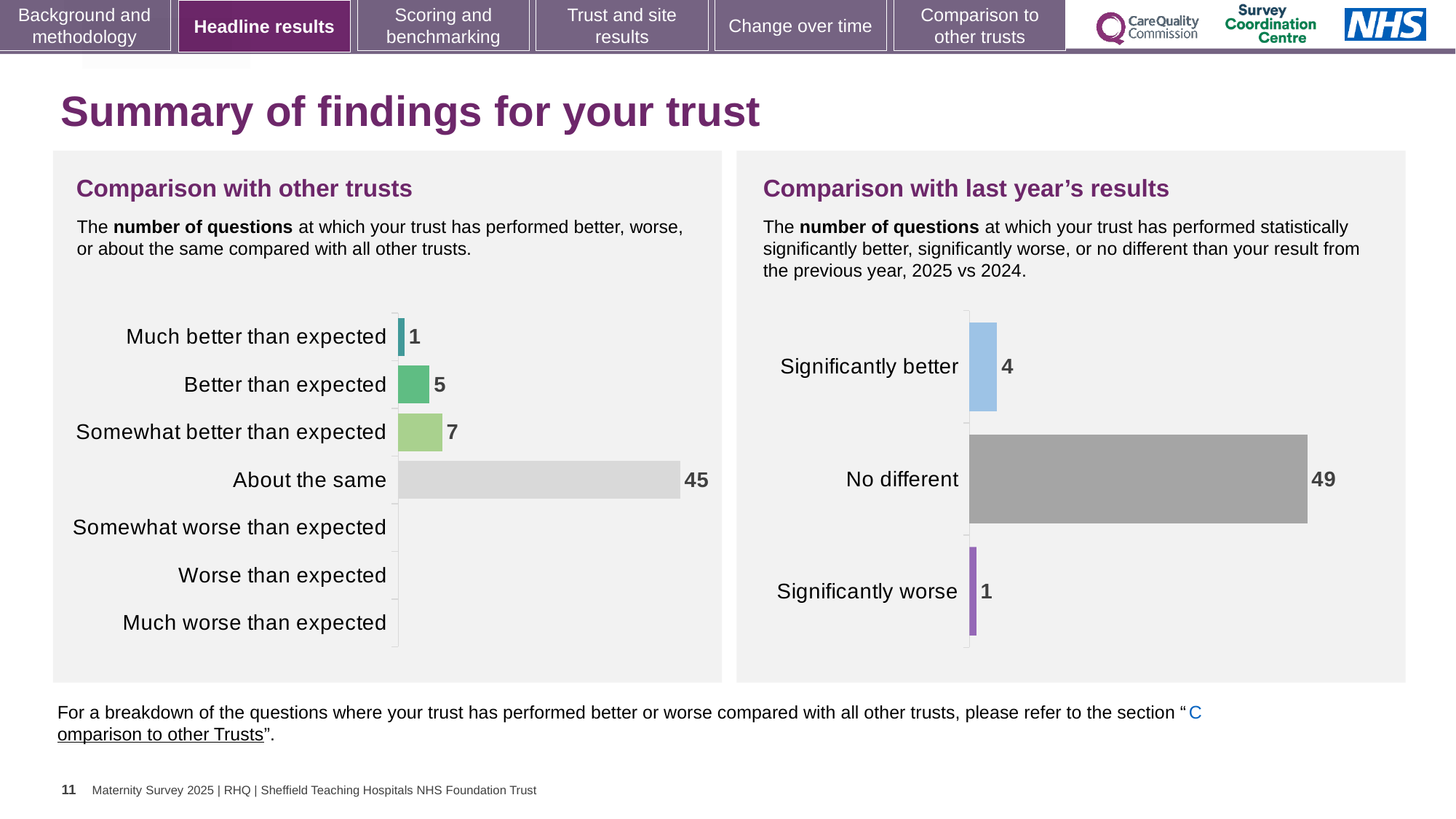
In the 'Comparison with last year's results' chart, what is the difference between 'Significantly better' and 'Significantly worse'? 3 In the 'Comparison with other trusts' chart, what is the difference between 'Somewhat better than expected' and 'Better than expected'? 2 In the 'Comparison with last year's results' chart, how many questions are 'Significantly better'? 4 In the 'Comparison with other trusts' chart, how many categories are listed on the vertical axis? 7 In the 'Comparison with last year's results' chart, which category has the lowest value? Significantly worse In the 'Comparison with other trusts' chart, which is larger: 'Better than expected' or 'Much better than expected'? Better than expected In the 'Comparison with other trusts' chart, how many questions are 'About the same'? 45 In the 'Comparison with last year's results' chart, what is the total of the three categories? 54 In the 'Comparison with other trusts' chart, which category has the highest value? About the same In the 'Comparison with last year's results' chart, how many questions are 'No different'? 49 In the 'Comparison with other trusts' chart, how many questions are 'Somewhat better than expected'? 7 What type of chart is the 'Comparison with last year's results' chart? Bar chart